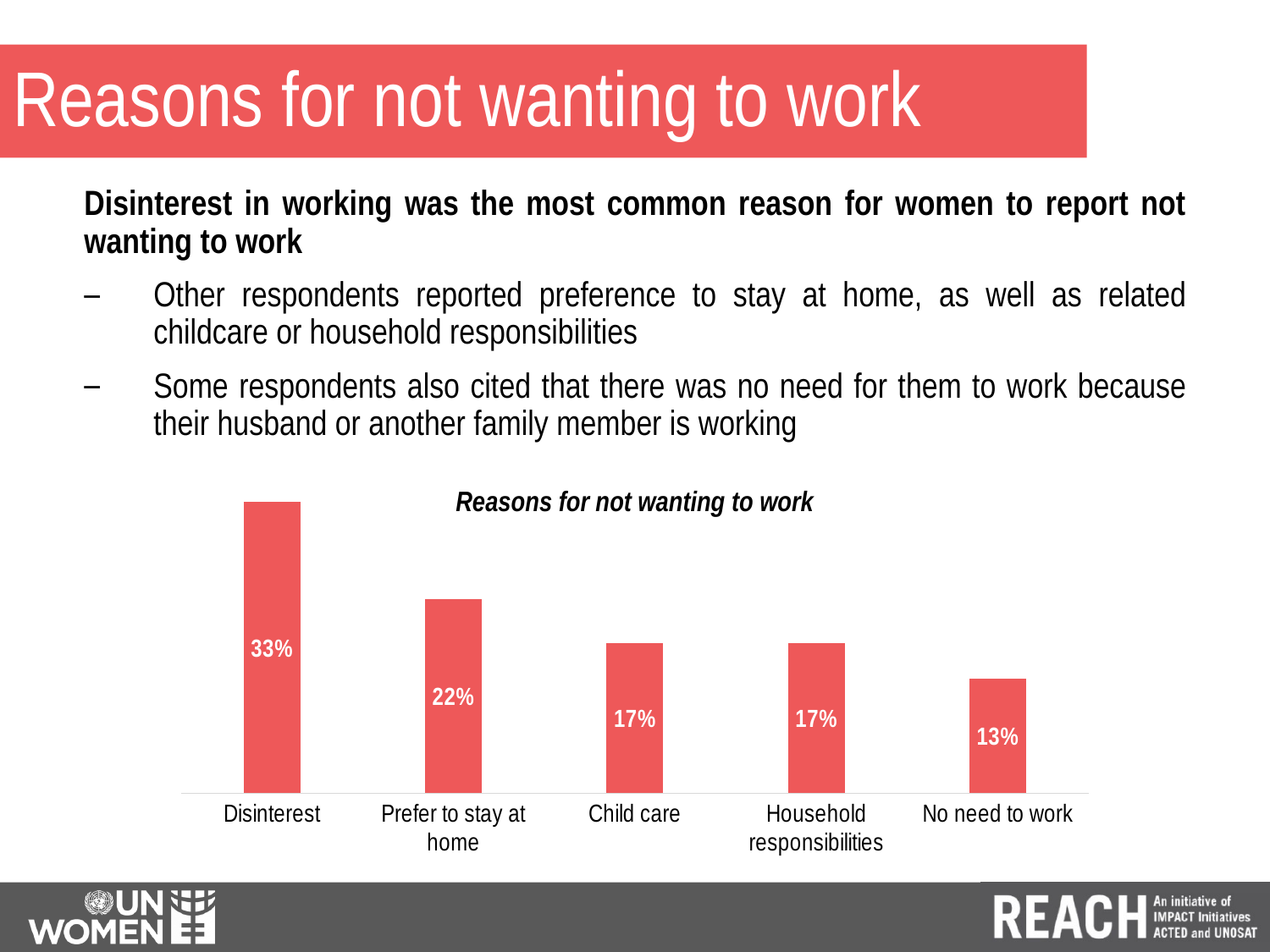
Which reason has the highest value? Disinterest Which is larger, the value for Prefer to stay at home or the value for Child care? Prefer to stay at home What is the value for No need to work? 13% What is the value for Disinterest? 33% What is the difference between the values for Disinterest and Prefer to stay at home? 11% What kind of chart is shown on the slide? Bar chart What is the value for Prefer to stay at home? 22% What is the title of the chart? Reasons for not wanting to work How many reasons are shown in the chart? 5 Which reason has the lowest value? No need to work What is the difference between the values for Household responsibilities and No need to work? 4% What is the value for Child care? 17%